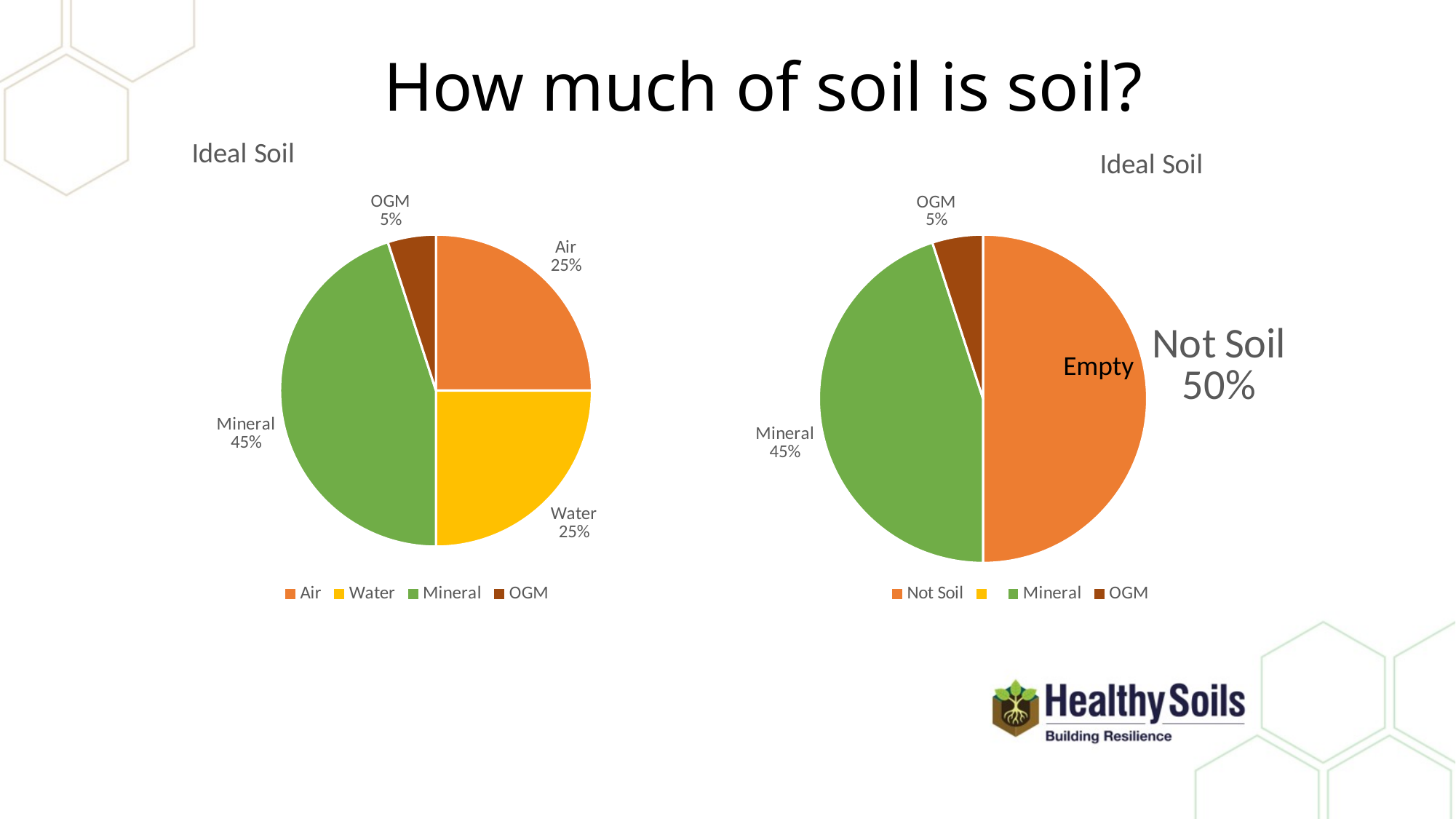
In the left pie chart, which category has the largest share? Mineral What type of chart is the left chart? Pie chart In the right pie chart, which is larger, Not Soil or Mineral? Not Soil What is the title of the right chart? Ideal Soil How many slices does the left pie chart have? 4 In the left pie chart, what percentage is Water? 25% In the right pie chart, what percentage is Not Soil? 50% In the left pie chart, what is the difference between the Mineral and Air percentages? 20% In the left pie chart, which category has the smallest share? OGM In the right pie chart, what percentage is OGM? 5% In the left pie chart, what percentage is Mineral? 45% In the right pie chart, which category has the largest share? Not Soil